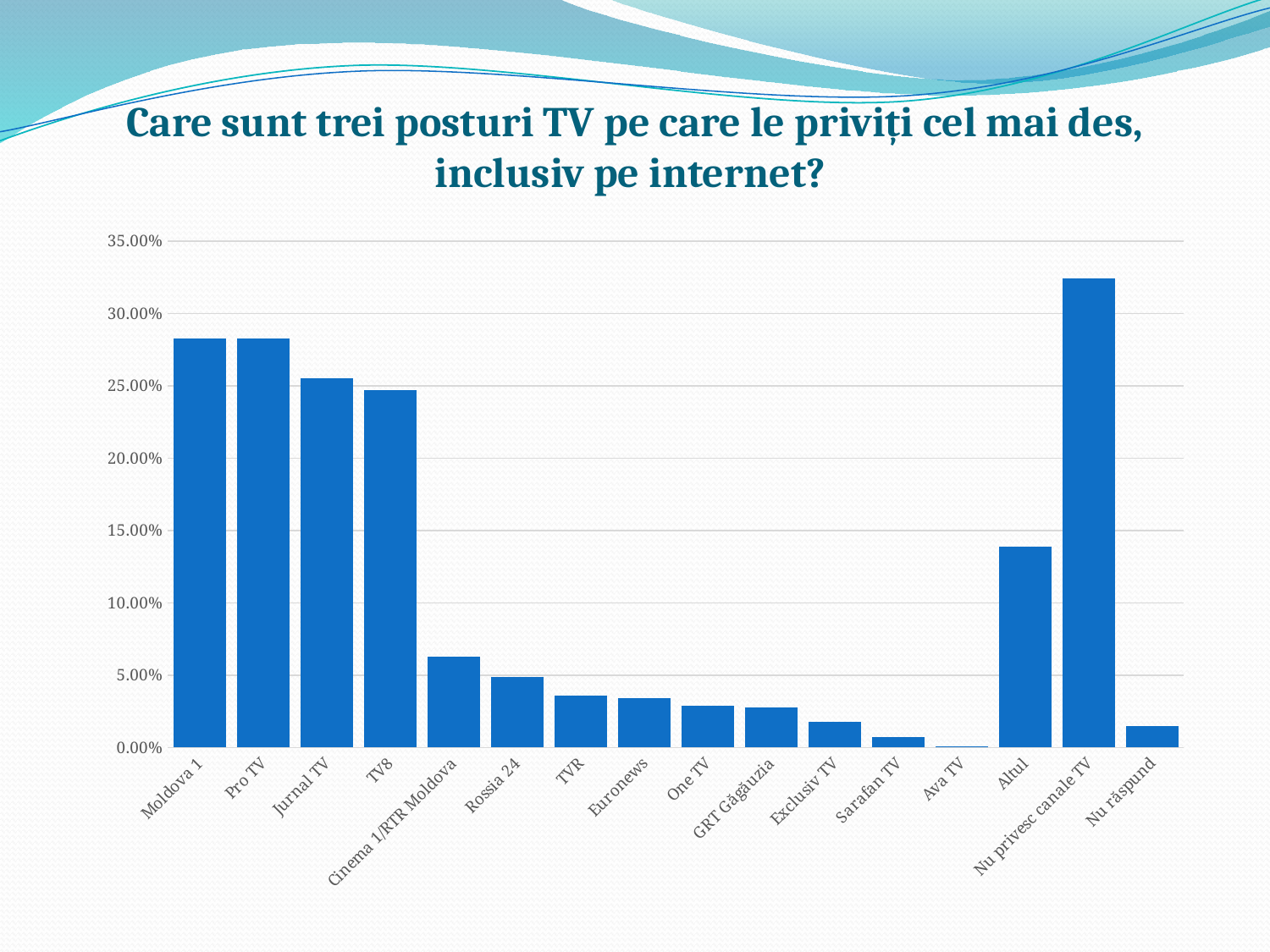
What kind of chart is shown on the slide? bar chart Which has a larger value, Jurnal TV or Cinema 1/RTR Moldova? Jurnal TV Which category has the highest value in the chart? Nu privesc canale TV Which category has the lowest value in the chart? Ava TV Is the value for Moldova 1 greater or less than 25.00%? greater Is the value for Nu privesc canale TV greater or less than 30.00%? greater Is the value for Altul greater or less than 15.00%? less Which has a larger value, Altul or Rossia 24? Altul How many categories are shown on the x axis of the chart? 16 What is the title of the slide containing the chart? Care sunt trei posturi TV pe care le priviți cel mai des, inclusiv pe internet?